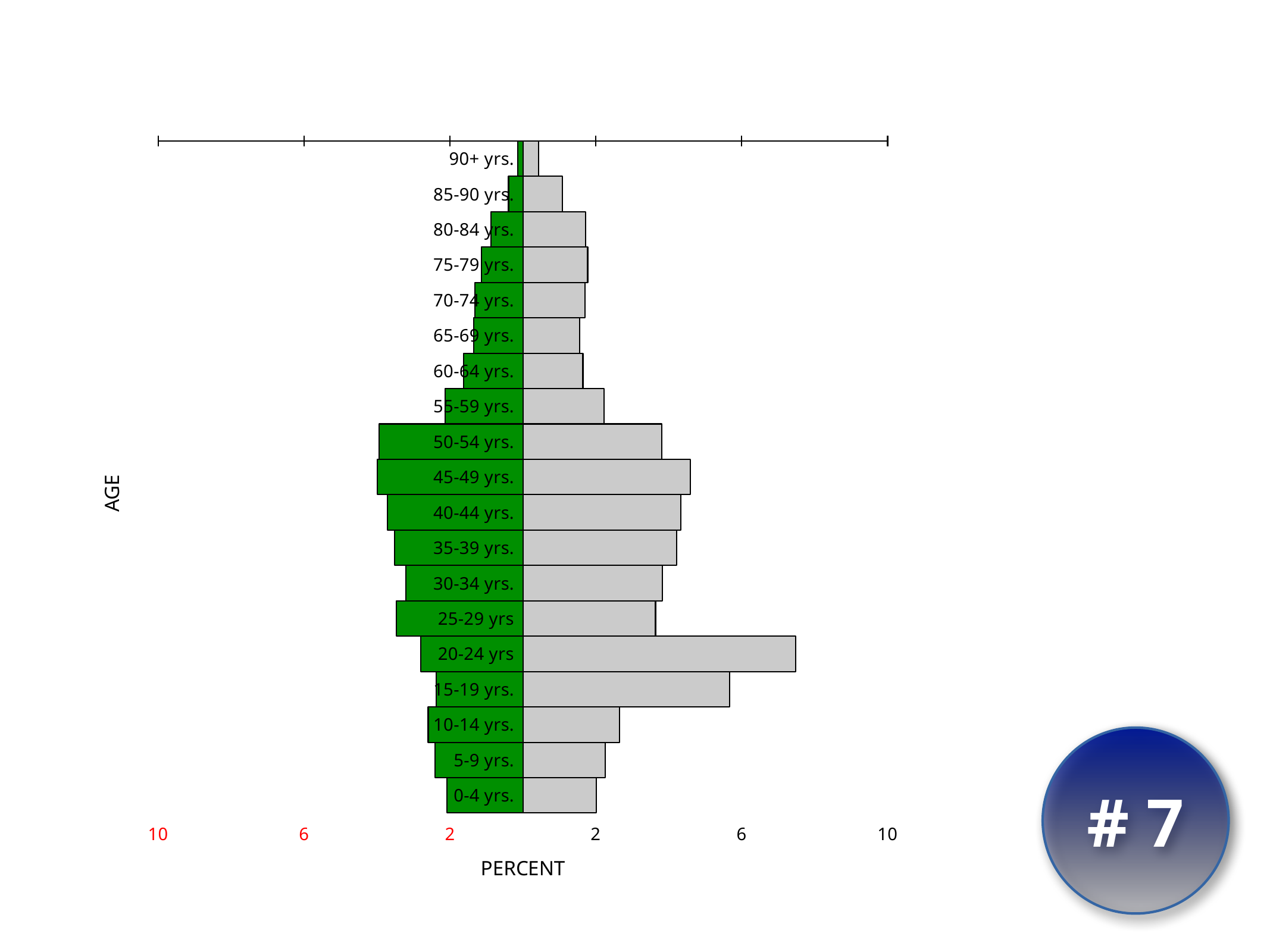
For the 20-24 yrs age group, which bar is longer, the green bar or the grey bar? the grey bar Which is larger, the grey bar for 20-24 yrs or the grey bar for 25-29 yrs? 20-24 yrs Is the green bar for 60-64 yrs. greater or less than 2 percent? less Is the green bar for 20-24 yrs greater or less than 2 percent? greater How many age groups are plotted on the chart? 19 Which age group has the longest grey bar on the right side of the chart? 20-24 yrs What is the label of the horizontal axis? PERCENT Is the grey bar for 20-24 yrs greater or less than 6 percent? greater Which age group has the shortest grey bar on the right side of the chart? 90+ yrs. Which age group has the shortest green bar on the left side of the chart? 90+ yrs. What kind of chart is shown on the slide? bar chart